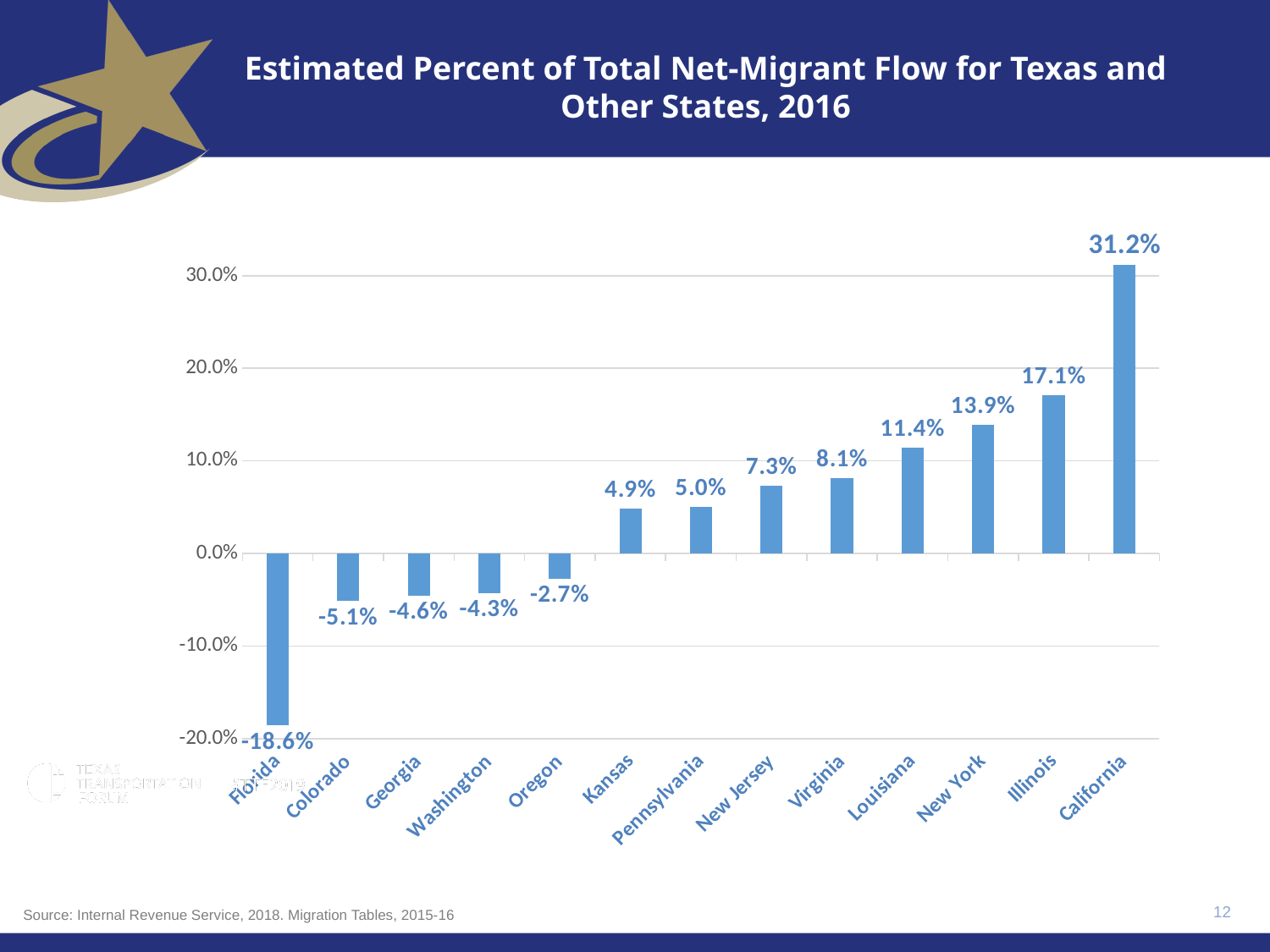
What is the value for Louisiana? 11.4% Do the values rise or fall from left to right along the x axis? rise What is the title of the chart? Estimated Percent of Total Net-Migrant Flow for Texas and Other States, 2016 What is the value for California? 31.2% Is the value for New York greater or less than 10.0%? greater Which state has the lowest value? Florida What is the value for Florida? -18.6% What is the difference between the values for Illinois and New York? 3.2% Which state has the highest value? California Which is larger, the value for Virginia or the value for New Jersey? Virginia What kind of chart is this? bar chart How many states are shown on the chart? 13